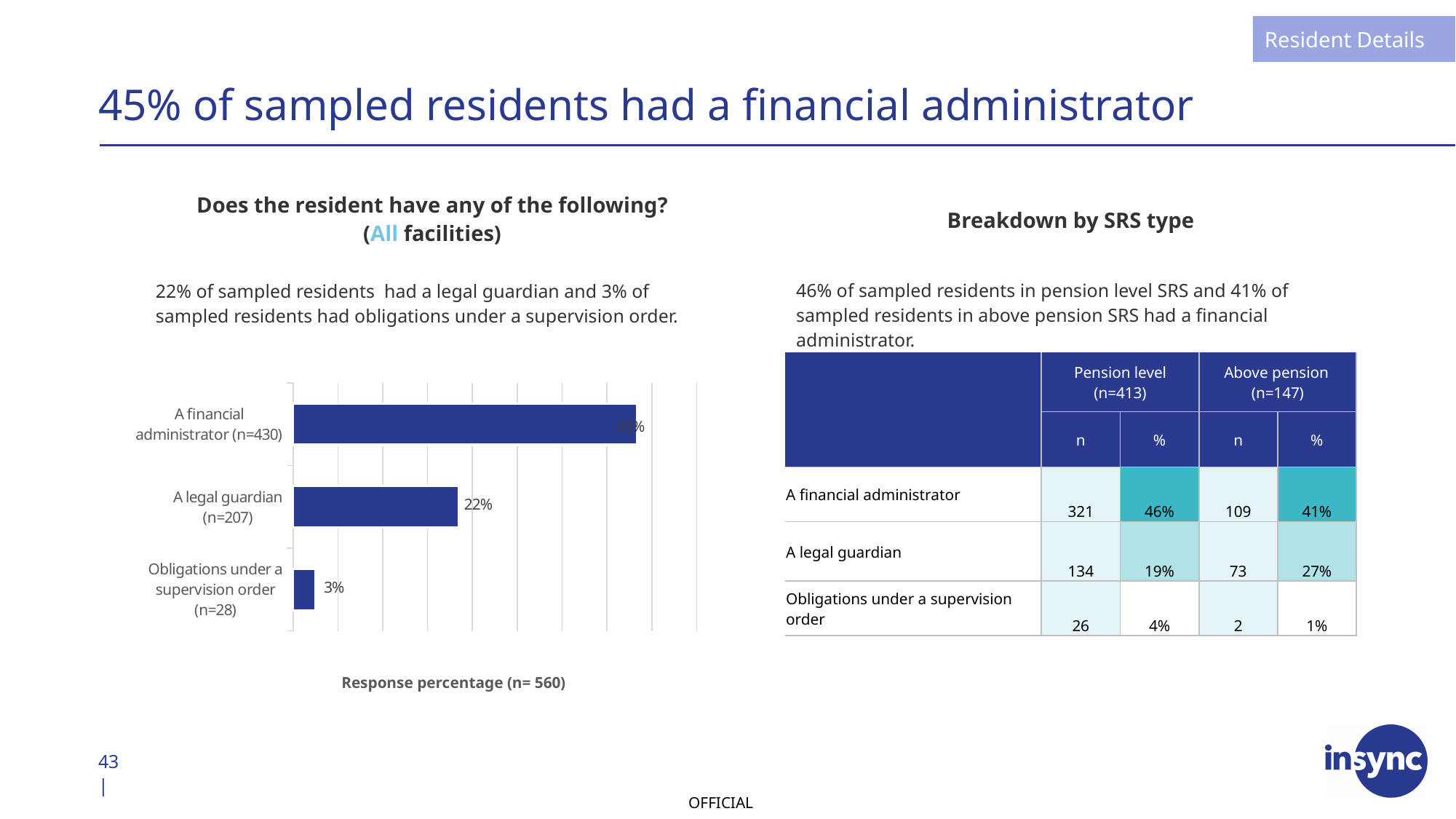
Which is larger in the bar chart: the value for 'A legal guardian' or the value for 'Obligations under a supervision order'? A legal guardian What is the value for 'A financial administrator' in the bar chart? 45% Which category has the highest value in the bar chart? A financial administrator What is the difference between the values for 'A legal guardian' and 'Obligations under a supervision order'? 19% What is the difference between the values for 'A financial administrator' and 'A legal guardian'? 23% What is the x-axis label of the bar chart? Response percentage (n= 560) What is the sample size (n) shown for 'A legal guardian' in the bar chart's category label? 207 How many categories does the bar chart show? 3 What type of chart is shown on the slide? bar chart What is the value for 'Obligations under a supervision order' in the bar chart? 3% What is the value for 'A legal guardian' in the bar chart? 22% Which category has the lowest value in the bar chart? Obligations under a supervision order